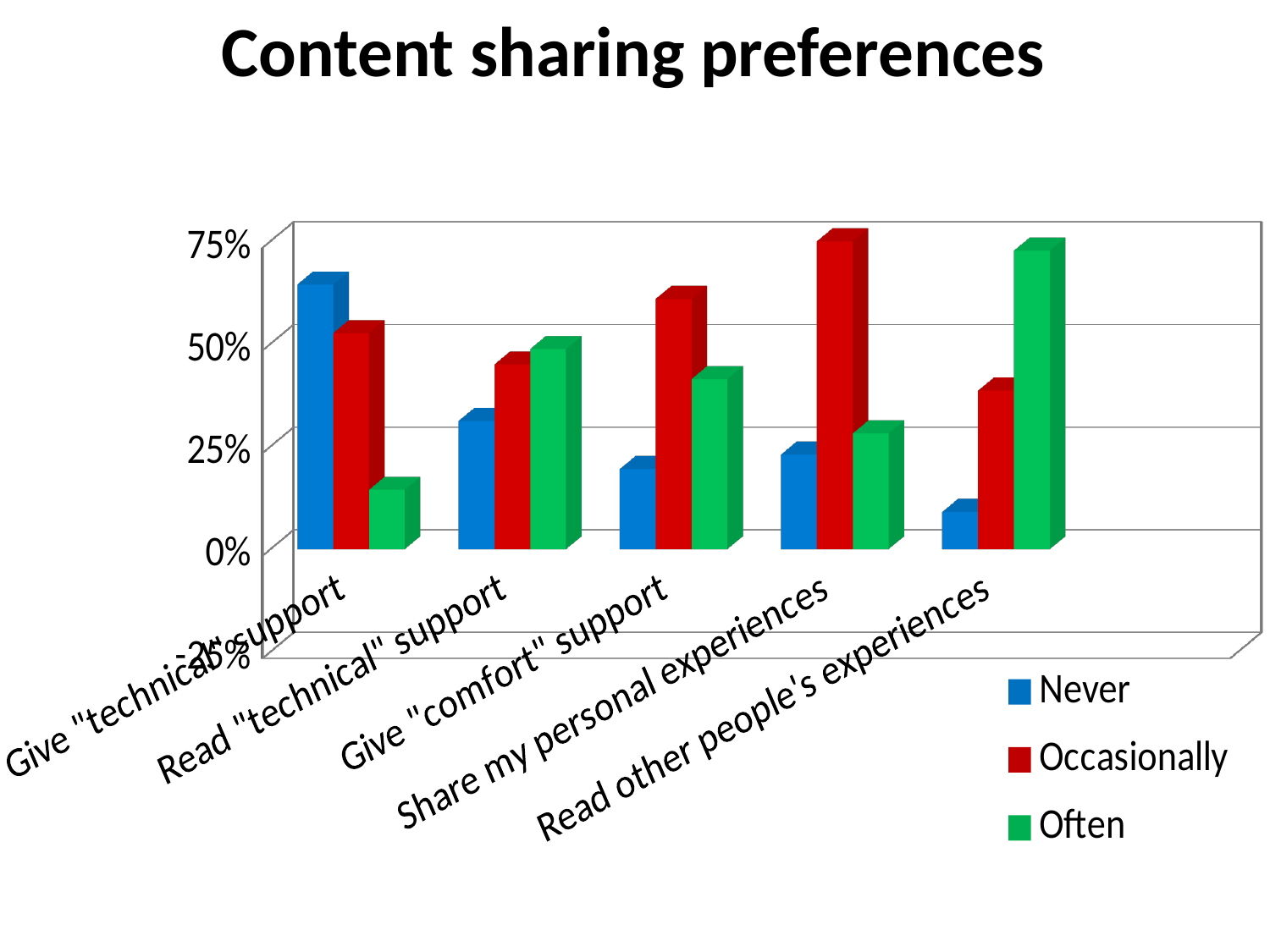
For Give "comfort" support, which is larger: the Occasionally value or the Never value? Occasionally Is the Occasionally value for Share my personal experiences greater or less than 50%? greater Is the Never value for Read other people's experiences greater or less than 25%? less Is the Often value for Give "technical" support greater or less than 25%? less Which category has the highest Never value? Give "technical" support Which category has the lowest Never value? Read other people's experiences Which series is shown in green in the legend? Often How many series does the legend list? 3 What is the title of the chart? Content sharing preferences What kind of chart is shown on the slide? bar chart How many categories are shown on the x axis? 5